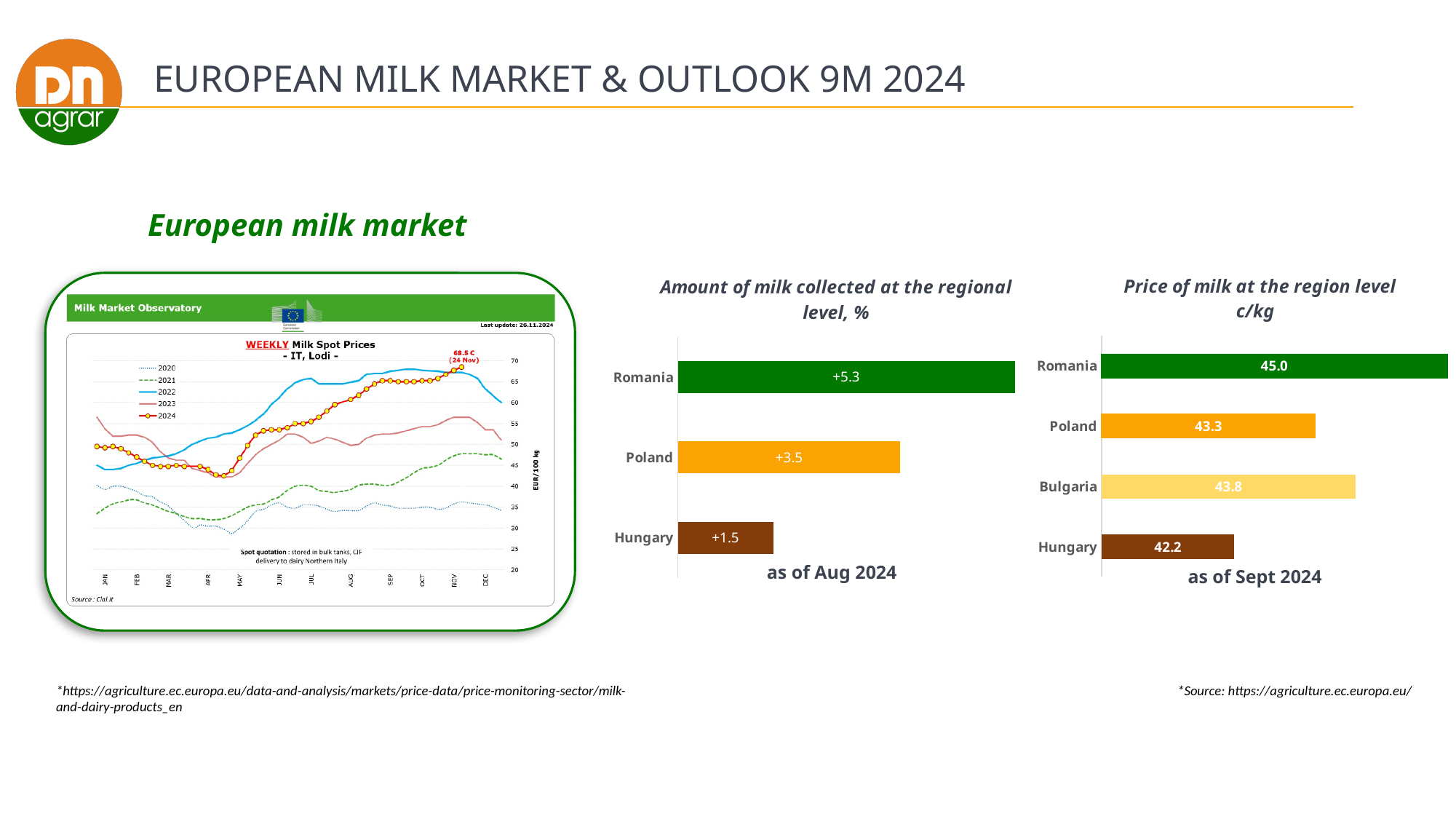
How many series does the legend of the 'Weekly Milk Spot Prices - IT, Lodi' line chart list? 5 In the 'Price of milk at the region level c/kg' chart, what is the value for Bulgaria? 43.8 How many countries are shown in the 'Price of milk at the region level c/kg' chart? 4 In the 'Weekly Milk Spot Prices - IT, Lodi' line chart, what value is labelled at the end of the 2024 line? 68.5 In the 'Amount of milk collected at the regional level, %' chart, what is the value for Romania? +5.3 What date note is shown under the 'Amount of milk collected at the regional level, %' chart? as of Aug 2024 In the 'Amount of milk collected at the regional level, %' chart, what is the difference between Romania and Poland? 1.8 In the 'Price of milk at the region level c/kg' chart, which is larger, Poland or Bulgaria? Bulgaria In the 'Price of milk at the region level c/kg' chart, which country has the highest price? Romania In the 'Amount of milk collected at the regional level, %' chart, which country has the lowest value? Hungary In the 'Price of milk at the region level c/kg' chart, what is the difference between Romania and Hungary? 2.8 What kind of chart is 'Amount of milk collected at the regional level, %'? bar chart